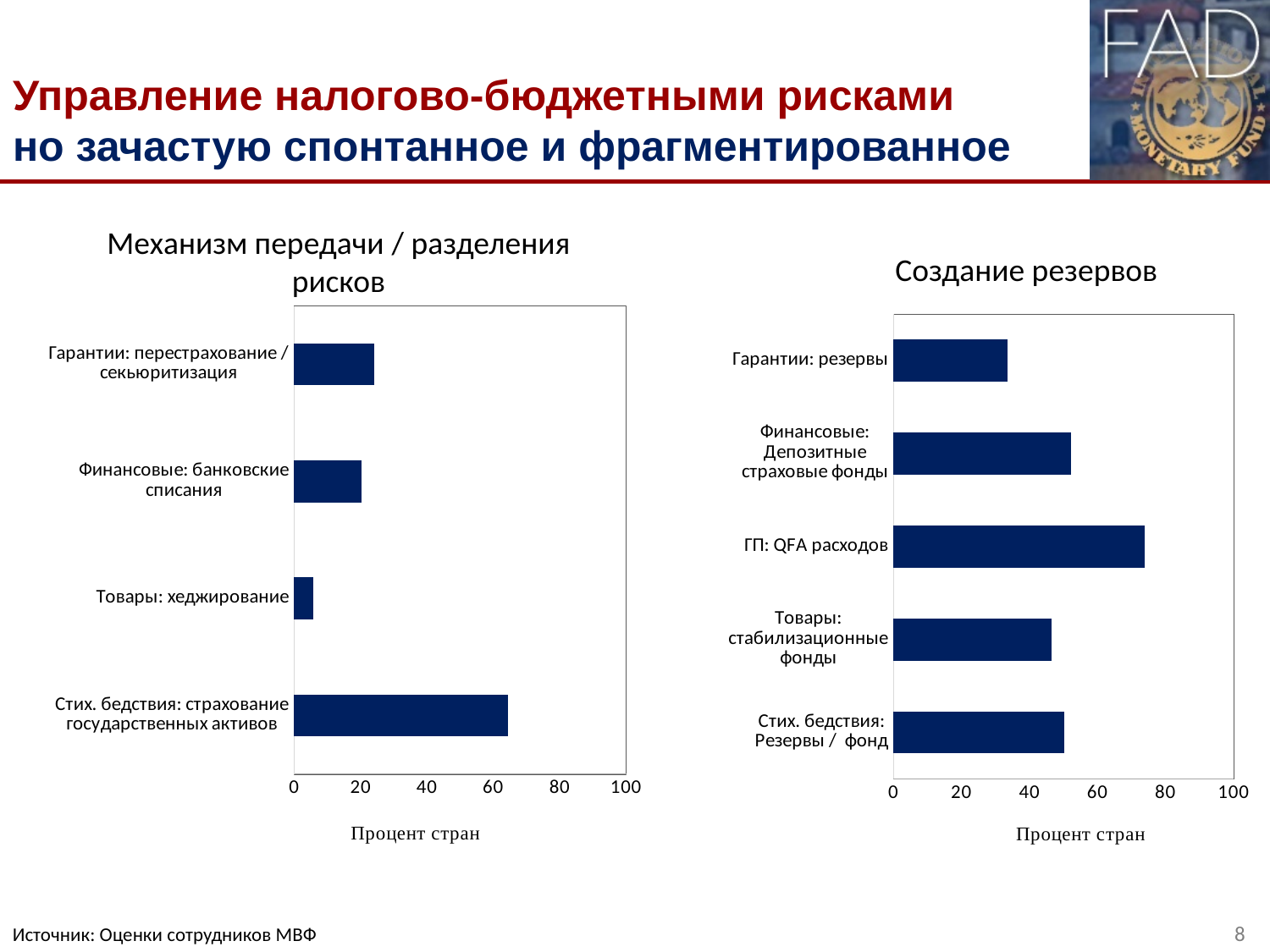
In the 'Создание резервов' chart, is the value for 'ГП: QFA расходов' greater or less than 60? greater What is the x-axis label of the 'Создание резервов' chart? Процент стран In the 'Создание резервов' chart, which category has the highest value? ГП: QFA расходов In the 'Создание резервов' chart, which is larger: 'Финансовые: Депозитные страховые фонды' or 'Гарантии: резервы'? Финансовые: Депозитные страховые фонды In the 'Механизм передачи / разделения рисков' chart, which category has the highest value? Стих. бедствия: страхование государственных активов In the 'Механизм передачи / разделения рисков' chart, is the value for 'Товары: хеджирование' greater or less than 20? less In the 'Механизм передачи / разделения рисков' chart, is the value for 'Стих. бедствия: страхование государственных активов' greater or less than 60? greater How many categories are shown in the 'Создание резервов' chart? 5 How many categories are shown in the 'Механизм передачи / разделения рисков' chart? 4 In the 'Создание резервов' chart, which category has the lowest value? Гарантии: резервы In the 'Механизм передачи / разделения рисков' chart, which category has the lowest value? Товары: хеджирование What kind of chart is the 'Механизм передачи / разделения рисков' chart on the left? bar chart